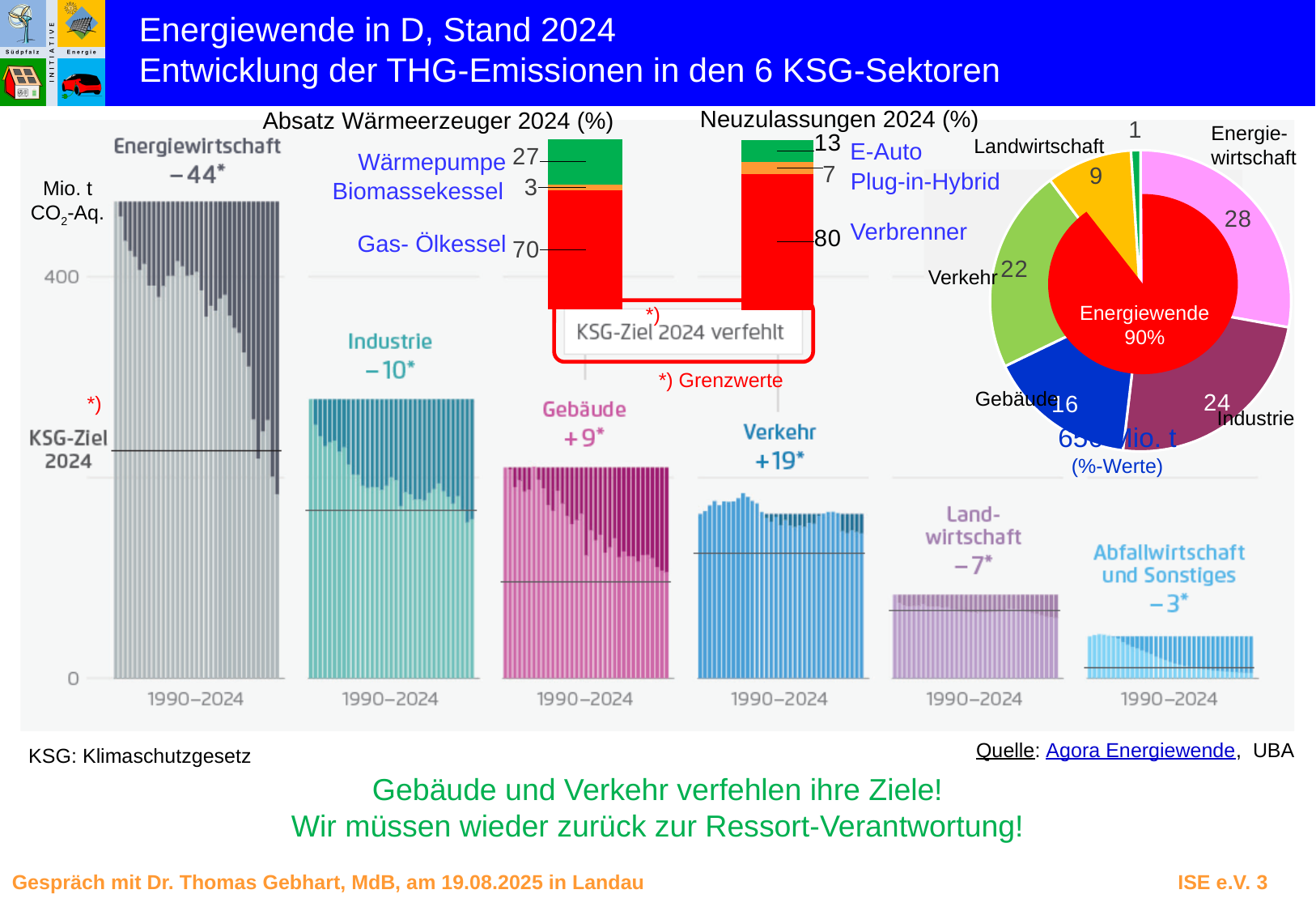
In the pie chart on the right, what is the value shown for Industrie? 24 In the 'Absatz Wärmeerzeuger 2024 (%)' stacked bar, which segment is the smallest? Biomassekessel In the 'Neuzulassungen 2024 (%)' stacked bar, what is the difference between Verbrenner and Plug-in-Hybrid? 73 In the 'Absatz Wärmeerzeuger 2024 (%)' stacked bar, what is the value for Gas- Ölkessel? 70 In the pie chart on the right, what is the difference between Energiewirtschaft and Landwirtschaft? 19 In the pie chart on the right, which sector has the largest share? Energiewirtschaft In the pie chart on the right, which is larger, Verkehr or Gebäude? Verkehr In the 'Neuzulassungen 2024 (%)' stacked bar, what is the value for Verbrenner? 80 In the large emissions chart, what change is shown for the Verkehr sector? +19* In the 'Neuzulassungen 2024 (%)' stacked bar, what is the value for E-Auto? 13 In the 'Absatz Wärmeerzeuger 2024 (%)' stacked bar, what is the value for Wärmepumpe? 27 In the large emissions chart, what change is shown for the Energiewirtschaft sector? −44*